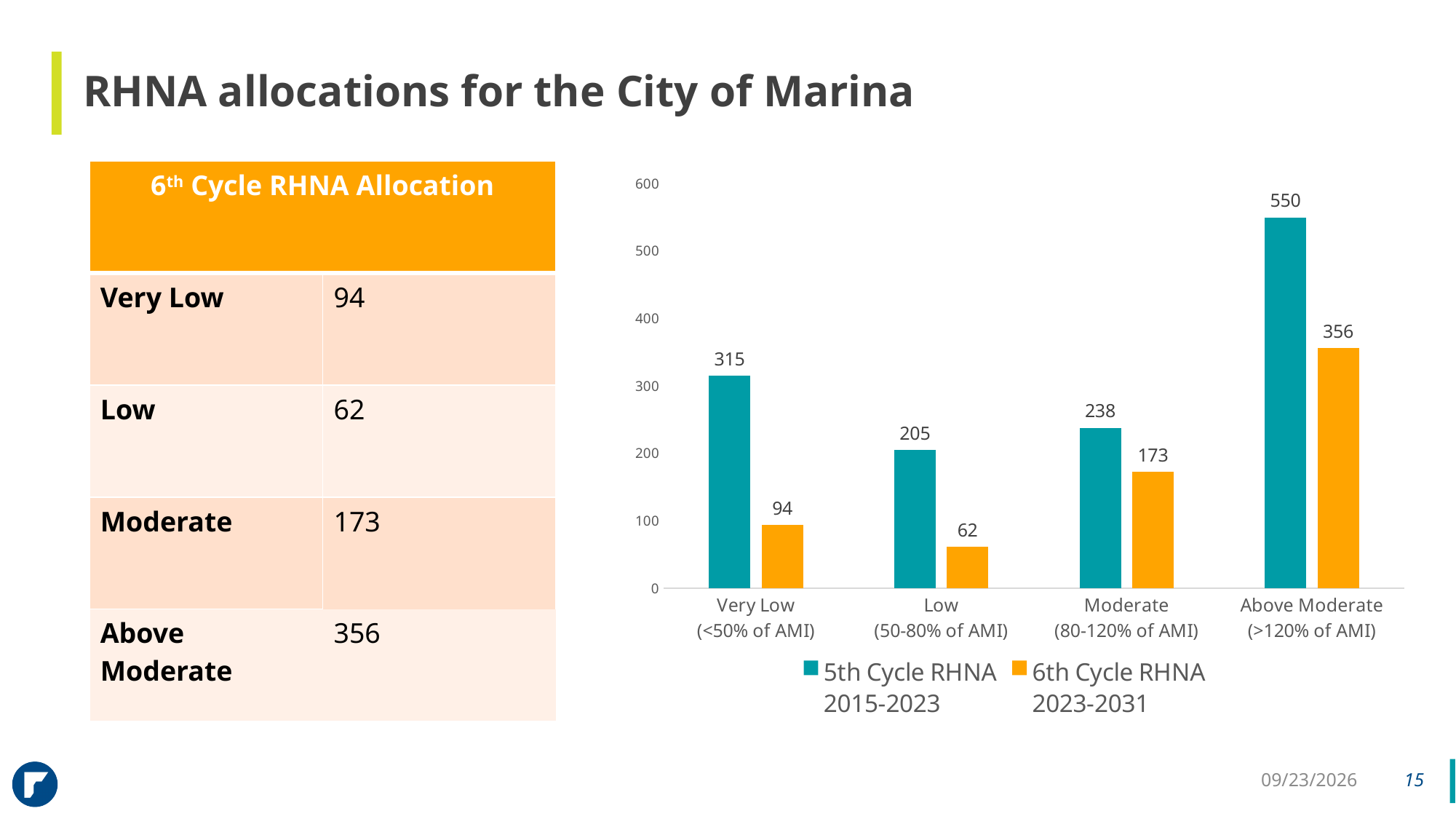
Which category has the highest 6th Cycle RHNA 2023-2031 value? Above Moderate (>120% of AMI) What is the 5th Cycle RHNA 2015-2023 value for the Very Low (<50% of AMI) category? 315 What kind of chart is shown on the slide? Bar chart What is the difference between the 5th Cycle RHNA and 6th Cycle RHNA values for the Above Moderate (>120% of AMI) category? 194 What is the 6th Cycle RHNA 2023-2031 value for the Moderate (80-120% of AMI) category? 173 Is the 5th Cycle RHNA 2015-2023 value for Moderate (80-120% of AMI) greater or less than 200? greater What is the difference between the 5th Cycle RHNA and 6th Cycle RHNA values for the Low (50-80% of AMI) category? 143 How many series does the chart legend list? 2 Which is larger: the 6th Cycle RHNA value for Very Low (<50% of AMI) or the 6th Cycle RHNA value for Moderate (80-120% of AMI)? Moderate (80-120% of AMI) How many categories are shown on the x axis of the chart? 4 Which category has the lowest 5th Cycle RHNA 2015-2023 value? Low (50-80% of AMI) What is the 5th Cycle RHNA 2015-2023 value for the Above Moderate (>120% of AMI) category? 550